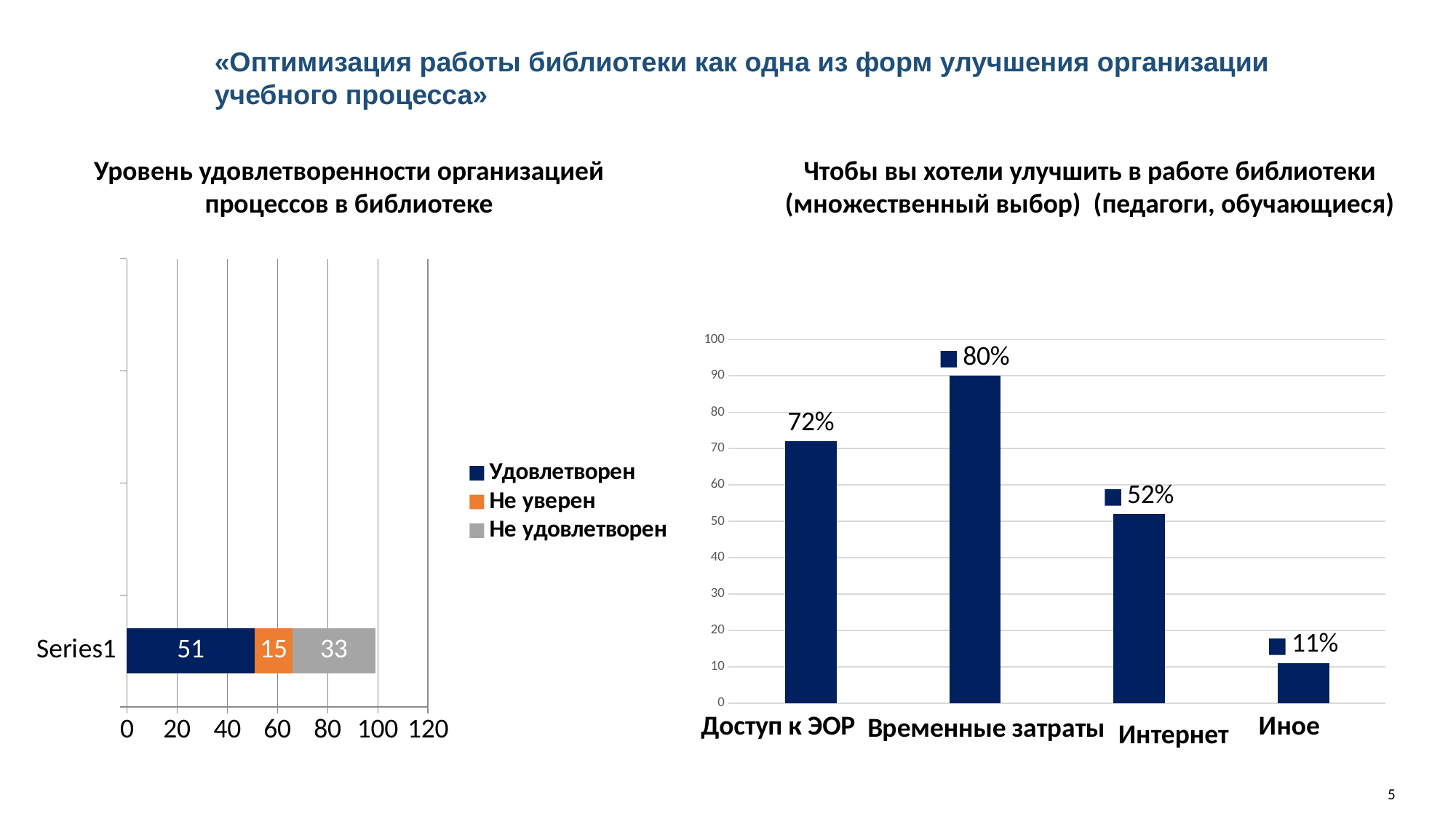
In the right chart (Чтобы вы хотели улучшить в работе библиотеки), what is the difference between Доступ к ЭОР and Иное? 61% In the left chart (Уровень удовлетворенности организацией процессов в библиотеке), what is the total of the stacked bar for Series1? 99 In the left chart (Уровень удовлетворенности организацией процессов в библиотеке), what is the difference between Удовлетворен and Не удовлетворен? 18 In the right chart (Чтобы вы хотели улучшить в работе библиотеки), how many categories are shown? 4 In the right chart (Чтобы вы хотели улучшить в работе библиотеки), what is the value for Интернет? 52% In the left chart (Уровень удовлетворенности организацией процессов в библиотеке), how many series does the legend list? 3 In the right chart (Чтобы вы хотели улучшить в работе библиотеки), which category has the highest value? Временные затраты In the right chart (Чтобы вы хотели улучшить в работе библиотеки), which category has the lowest value? Иное In the left chart (Уровень удовлетворенности организацией процессов в библиотеке), what is the value for Не уверен? 15 In the left chart (Уровень удовлетворенности организацией процессов в библиотеке), what is the value for Удовлетворен? 51 In the left chart (Уровень удовлетворенности организацией процессов в библиотеке), what is the value for Не удовлетворен? 33 In the right chart (Чтобы вы хотели улучшить в работе библиотеки), what is the value for Временные затраты? 80%